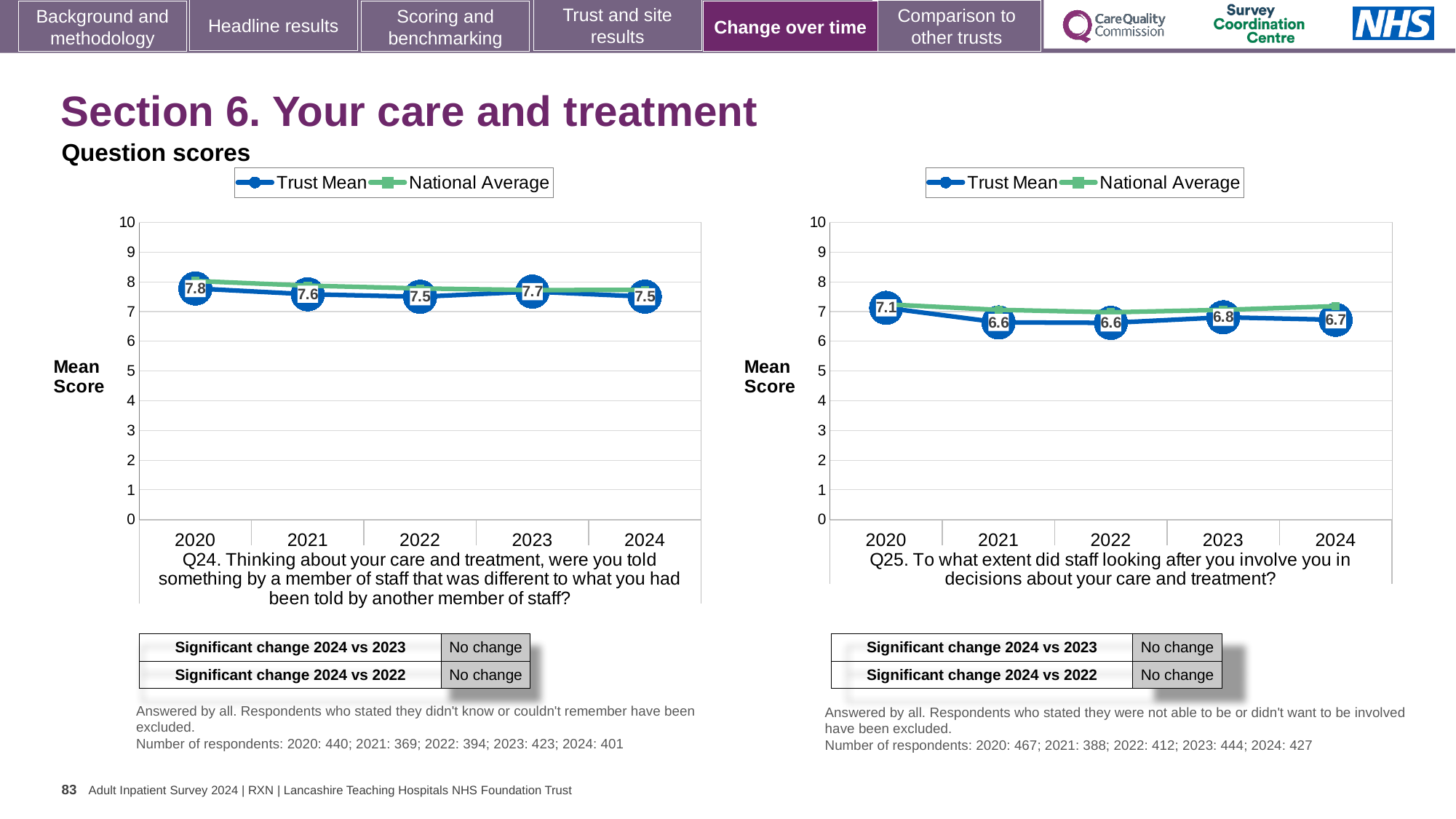
In the Q25 chart (right), which year has the highest Trust Mean score? 2020 How many years are plotted on the x axis of the Q24 chart (left)? 5 In the Q25 chart (right), what is the Trust Mean score for 2024? 6.7 In the Q25 chart (right), is the Trust Mean score for 2021 greater or less than 7? less In the Q24 chart (left), what is the Trust Mean score for 2023? 7.7 In the Q24 chart (left), which is larger, the Trust Mean score for 2021 or for 2023? 2023 How many series does the legend of the Q25 chart (right) list? 2 In the Q25 chart (right), what is the difference between the Trust Mean scores for 2020 and 2024? 0.4 In the Q24 chart (left), what is the Trust Mean score for 2020? 7.8 In the Q25 chart (right), what is the Trust Mean score for 2021? 6.6 In the Q24 chart (left), which year has the highest Trust Mean score? 2020 What kind of chart is the Q24 chart (left)? Line chart